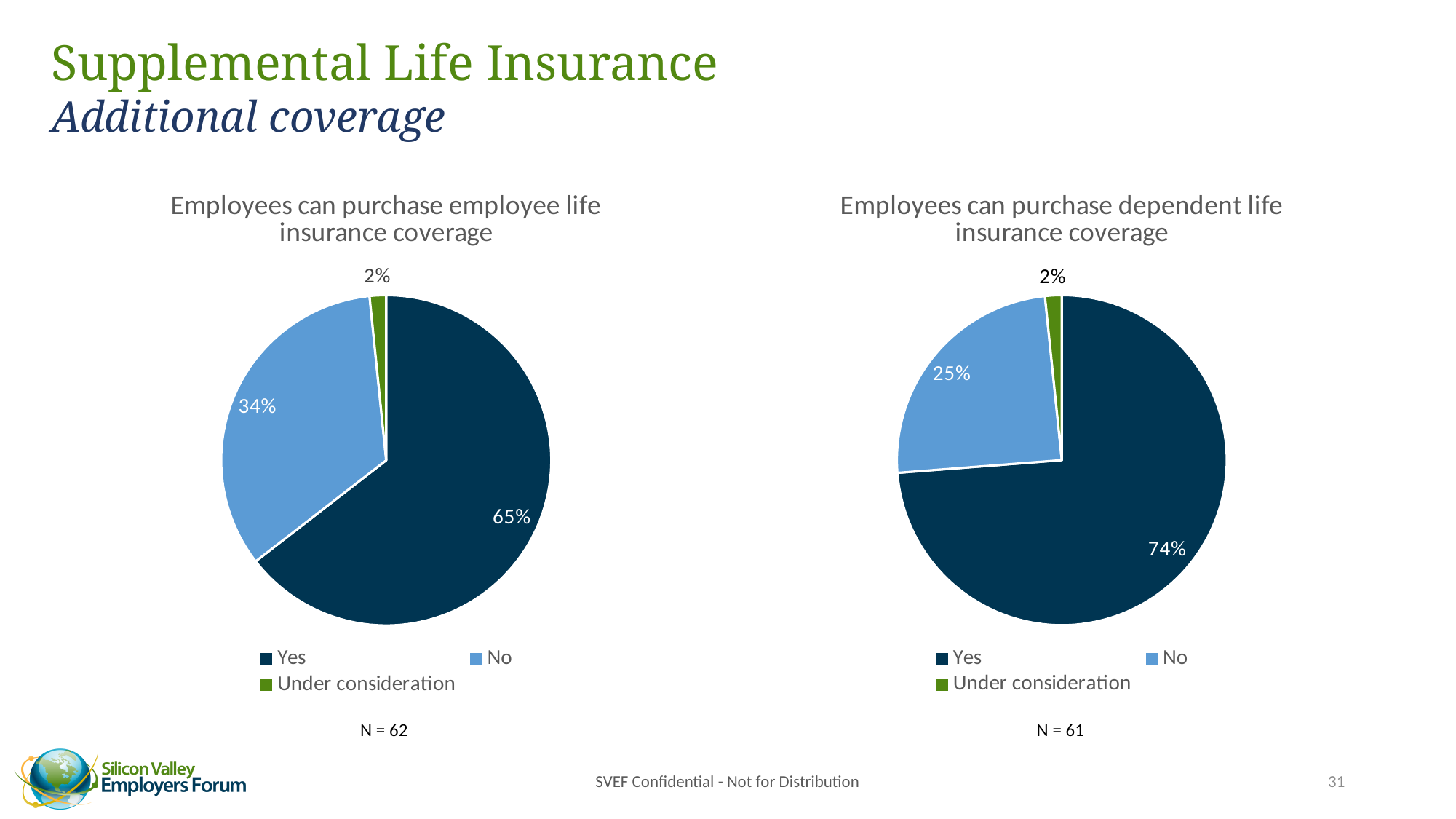
In the 'Employees can purchase dependent life insurance coverage' chart, what share of the pie is 'Yes'? 74% Which chart has the larger 'No' share, the employee life insurance chart or the dependent life insurance chart? Employee life insurance coverage In the 'Employees can purchase employee life insurance coverage' chart, which category has the largest slice? Yes In the 'Employees can purchase dependent life insurance coverage' chart, what is the value for 'No'? 25% In the 'Employees can purchase dependent life insurance coverage' chart, what is the difference between the 'Yes' and 'No' shares? 49% In the 'Employees can purchase employee life insurance coverage' chart, what is the difference between the 'Yes' and 'No' shares? 31% In the 'Employees can purchase employee life insurance coverage' chart, what share of the pie is 'Yes'? 65% In the 'Employees can purchase employee life insurance coverage' chart, what is the value for 'No'? 34% In the 'Employees can purchase dependent life insurance coverage' chart, which category has the smallest slice? Under consideration In the 'Employees can purchase dependent life insurance coverage' chart, what is the value for 'Under consideration'? 2% How many entries does the legend of the 'Employees can purchase dependent life insurance coverage' chart list? 3 What type of chart is used on the left side of the slide? Pie chart